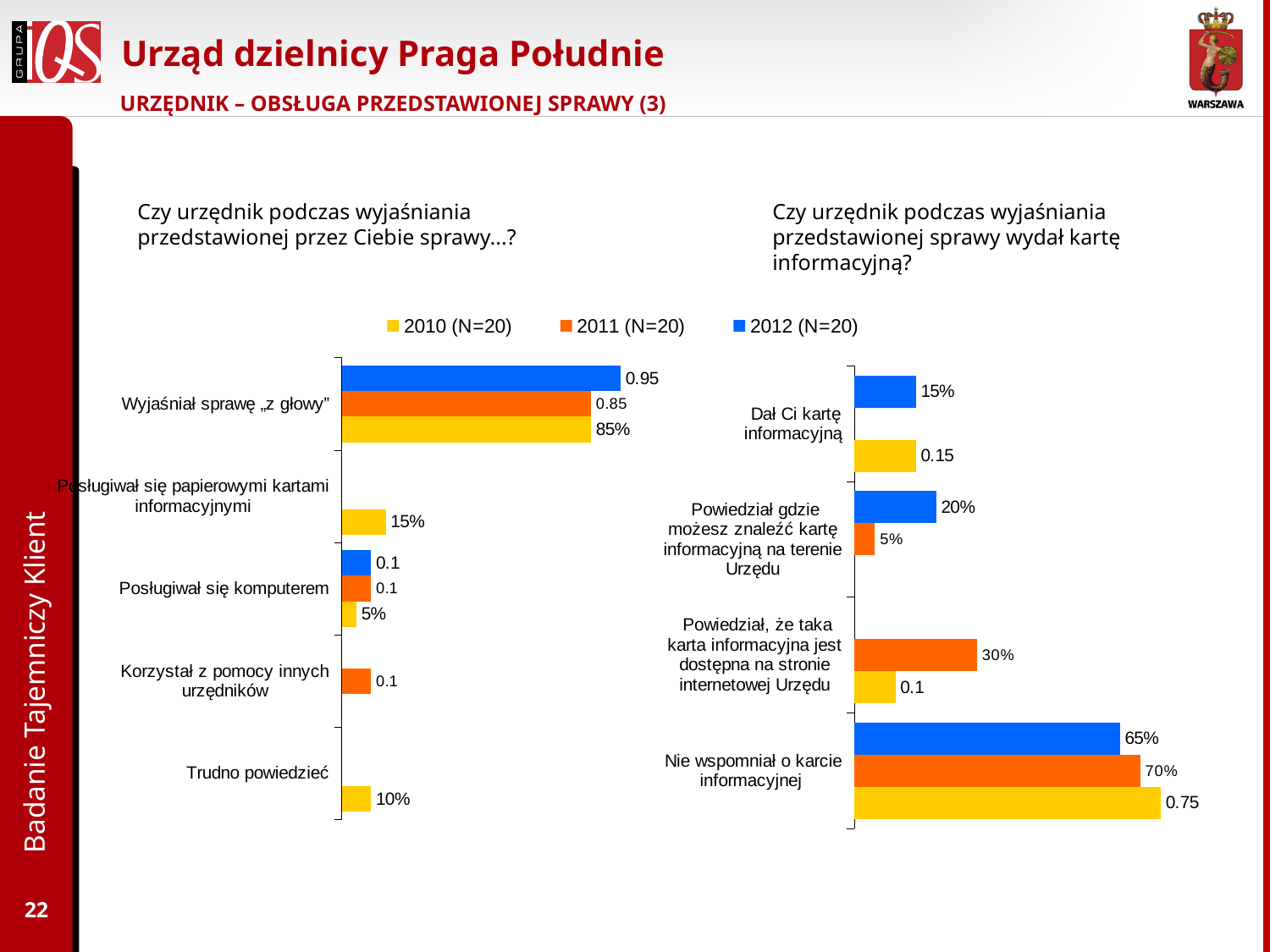
In the right chart, for "Nie wspomniał o karcie informacyjnej", which year has the larger value: 2011 (N=20) or 2012 (N=20)? 2011 (N=20) In the right chart, what is the difference between the 2011 (N=20) and 2012 (N=20) values for "Nie wspomniał o karcie informacyjnej"? 5% In the right chart, what is the 2012 (N=20) value for "Powiedział gdzie możesz znaleźć kartę informacyjną na terenie Urzędu"? 20% In the left chart, what is the 2010 (N=20) value for "Posługiwał się papierowymi kartami informacyjnymi"? 15% In the right chart, what is the 2010 (N=20) value for "Nie wspomniał o karcie informacyjnej"? 0.75 What kind of chart is the left chart? Bar chart In the left chart ("Czy urzędnik podczas wyjaśniania przedstawionej przez Ciebie sprawy...?"), what is the value for "Wyjaśniał sprawę „z głowy"" in 2012 (N=20)? 0.95 In the left chart, which category has the highest value for 2012 (N=20)? Wyjaśniał sprawę „z głowy" How many series does the legend list? 3 In the right chart ("Czy urzędnik podczas wyjaśniania przedstawionej sprawy wydał kartę informacyjną?"), what is the 2011 (N=20) value for "Nie wspomniał o karcie informacyjnej"? 70% In the left chart, what is the 2010 (N=20) value for "Trudno powiedzieć"? 10% In the right chart, which category has the lowest 2011 (N=20) value among those with a 2011 bar? Powiedział gdzie możesz znaleźć kartę informacyjną na terenie Urzędu